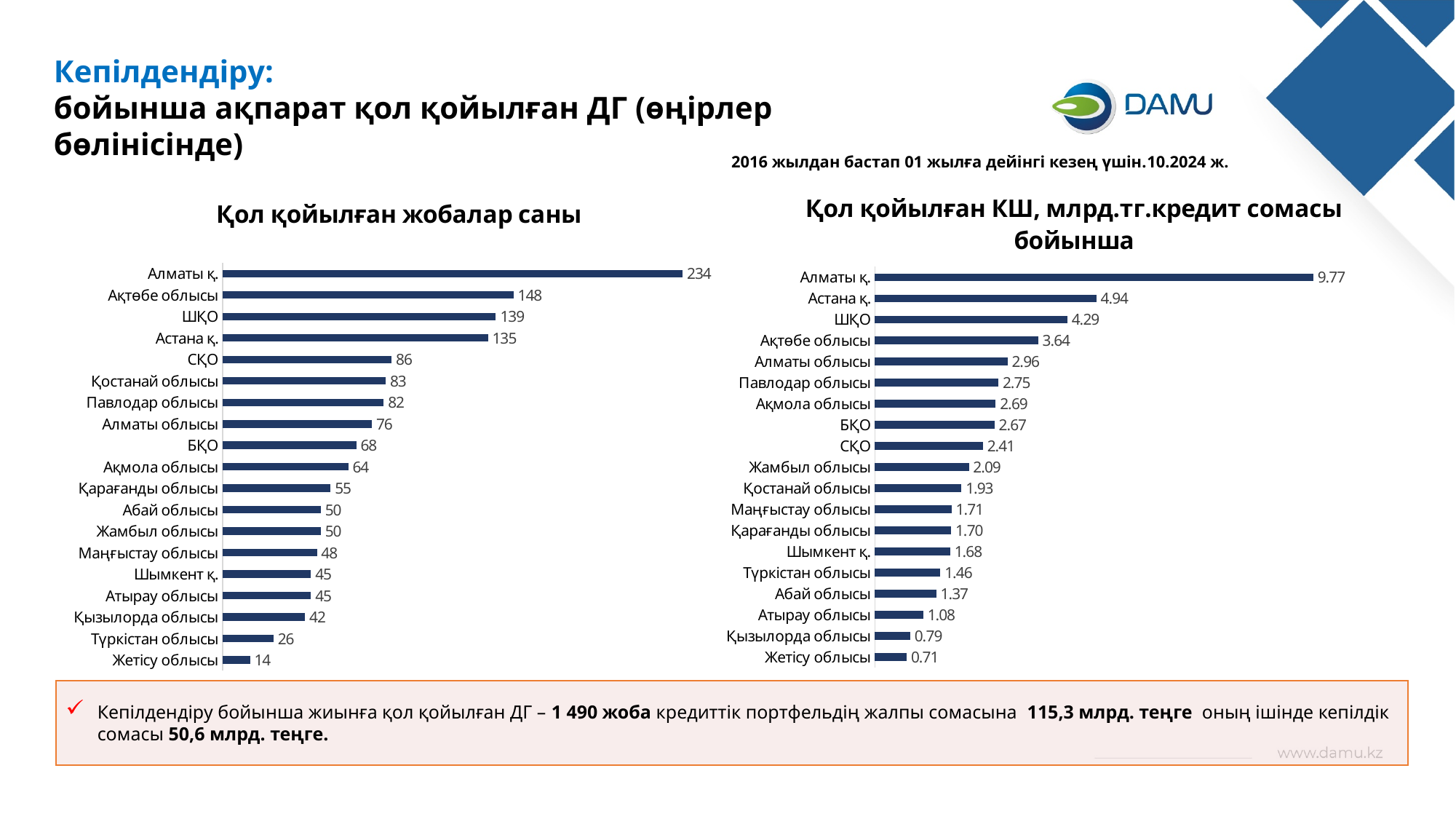
In the chart titled 'Қол қойылған КШ, млрд.тг.кредит сомасы бойынша', which is larger: the value for Павлодар облысы or Ақмола облысы? Павлодар облысы In the chart titled 'Қол қойылған жобалар саны', what is the difference between the values for Алматы қ. and Астана қ.? 99 In the chart titled 'Қол қойылған жобалар саны', what is the value for Түркістан облысы? 26 In the chart titled 'Қол қойылған жобалар саны', which region has the highest value? Алматы қ. In the chart titled 'Қол қойылған жобалар саны', which region has the lowest value? Жетісу облысы In the chart titled 'Қол қойылған жобалар саны', what is the value for Ақтөбе облысы? 148 In the chart titled 'Қол қойылған КШ, млрд.тг.кредит сомасы бойынша', what is the value for Қызылорда облысы? 0.79 In the chart titled 'Қол қойылған жобалар саны', how many regions are shown? 19 In the chart titled 'Қол қойылған КШ, млрд.тг.кредит сомасы бойынша', what is the value for Астана қ.? 4.94 In the chart titled 'Қол қойылған КШ, млрд.тг.кредит сомасы бойынша', which region has the lowest value? Жетісу облысы What type of chart is the chart titled 'Қол қойылған КШ, млрд.тг.кредит сомасы бойынша'? Bar chart In the chart titled 'Қол қойылған КШ, млрд.тг.кредит сомасы бойынша', what is the difference between the values for Алматы қ. and ШҚО? 5.48